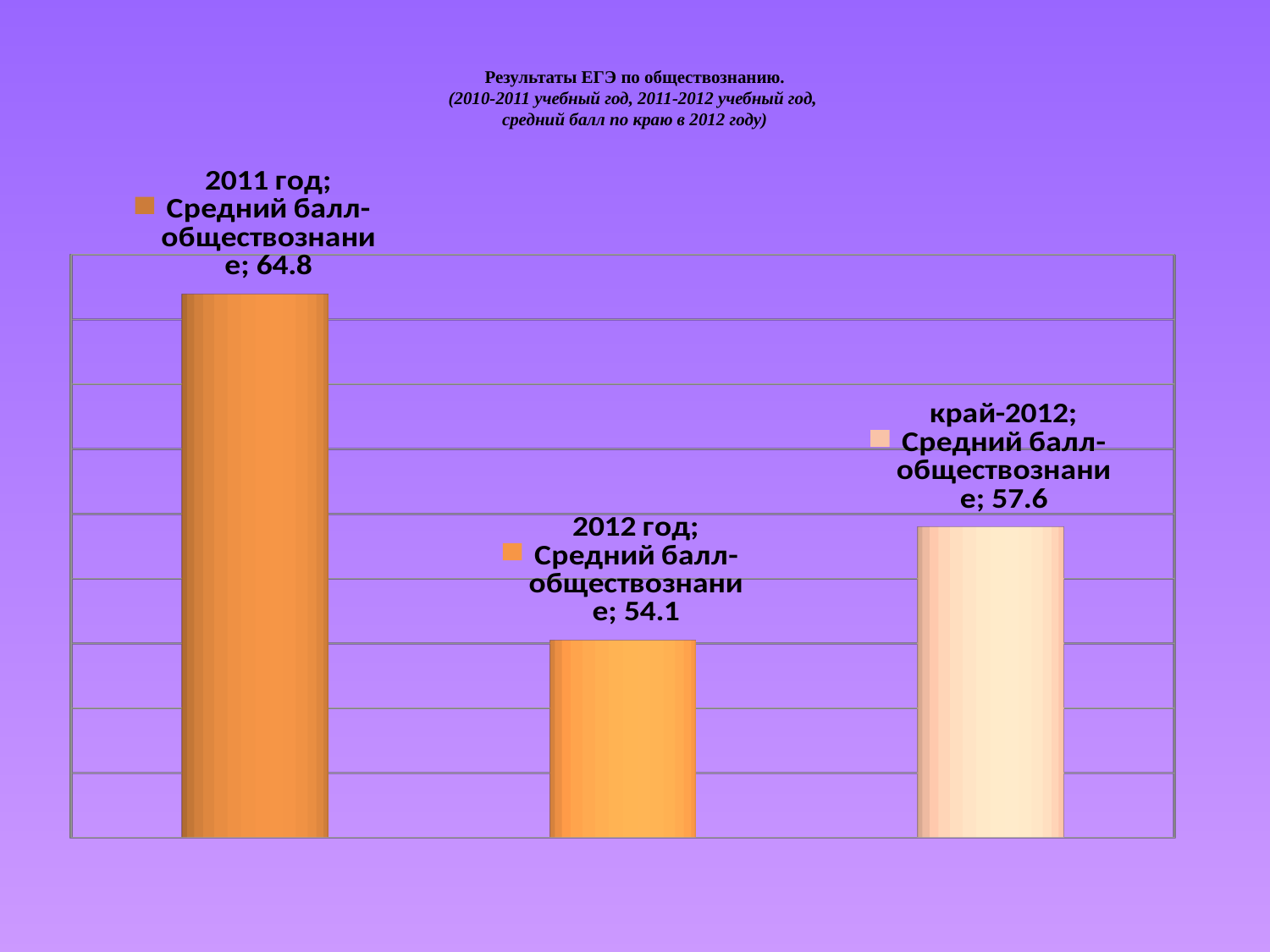
What is the difference between the average score for край-2012 and 2012 год? 3.5 What is the average score (Средний балл-обществознание) for край-2012? 57.6 What is the difference between the average score for 2011 год and 2012 год? 10.7 Which is larger: the average score for 2012 год or for край-2012? край-2012 How many bars are shown in the chart? 3 What is the average score (Средний балл-обществознание) for 2011 год? 64.8 Which category has the lowest average score? 2012 год Which category has the highest average score? 2011 год Does the average score rise or fall from 2011 год to 2012 год? Fall What is the first line of the chart's title? Результаты ЕГЭ по обществознанию. What is the average score (Средний балл-обществознание) for 2012 год? 54.1 What kind of chart is shown on the slide? Bar chart